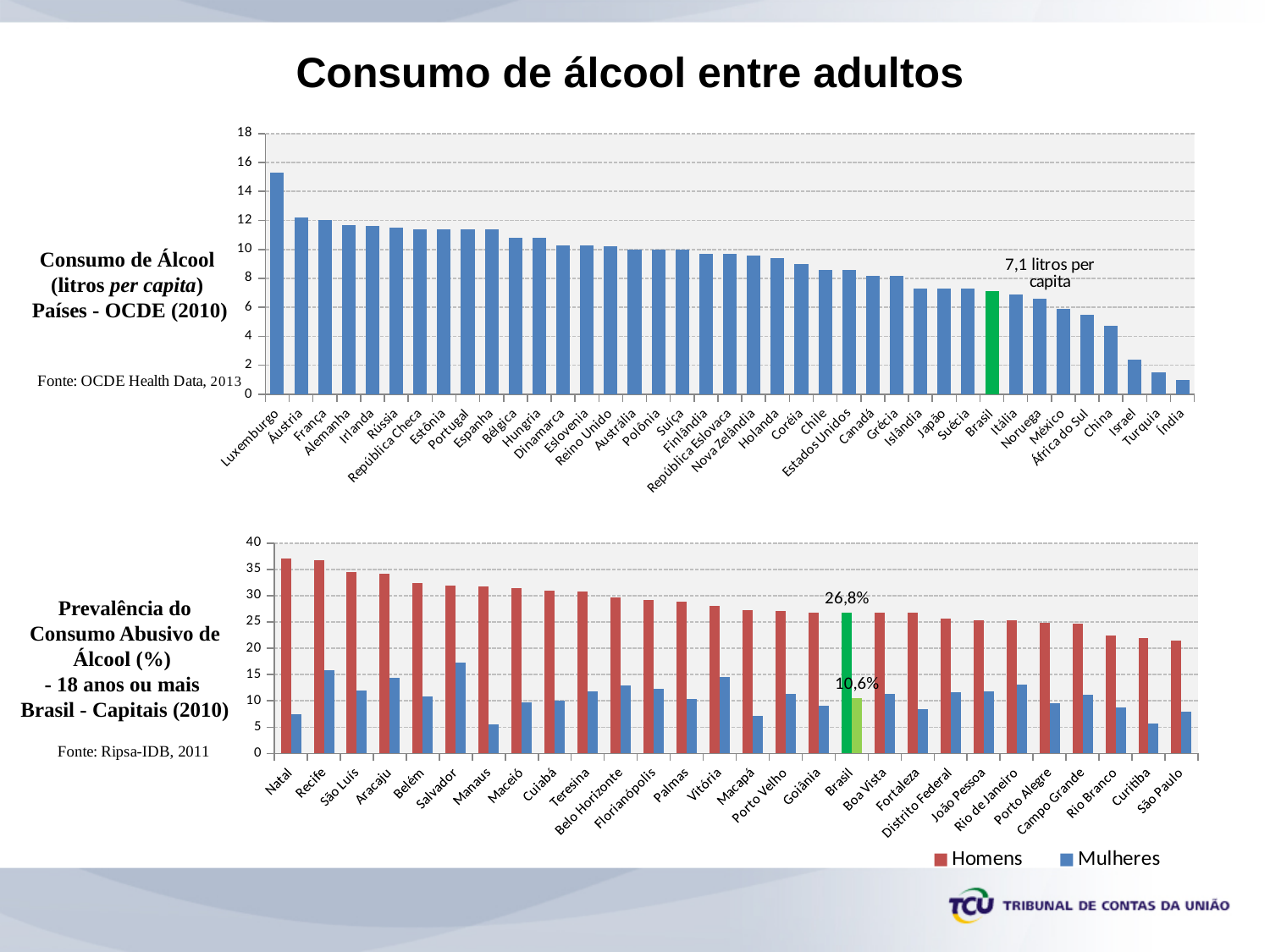
In the top chart (Consumo de Álcool, Países - OCDE 2010), do the values rise or fall from left to right along the x axis? fall In the top chart (Consumo de Álcool, Países - OCDE 2010), is the value for Luxemburgo greater or less than 14? greater In the bottom chart (Prevalência do Consumo Abusivo de Álcool, Brasil - Capitais 2010), is the Homens value for Natal greater or less than 35? greater How many series does the legend of the bottom chart (Prevalência do Consumo Abusivo de Álcool, Brasil - Capitais 2010) list? 2 What kind of chart is the top chart (Consumo de Álcool, Países - OCDE 2010)? bar chart In the bottom chart (Prevalência do Consumo Abusivo de Álcool, Brasil - Capitais 2010), what is the difference between the Homens and Mulheres values for Brasil? 16,2% In the bottom chart (Prevalência do Consumo Abusivo de Álcool, Brasil - Capitais 2010), what is the Homens value for Brasil? 26,8% In the bottom chart (Prevalência do Consumo Abusivo de Álcool, Brasil - Capitais 2010), what is the Mulheres value for Brasil? 10,6% In the top chart (Consumo de Álcool, Países - OCDE 2010), is the value for Turquia greater or less than 2? less In the top chart (Consumo de Álcool, Países - OCDE 2010), which country has the highest consumption? Luxemburgo In the top chart (Consumo de Álcool, Países - OCDE 2010), what is the value for Brasil? 7,1 litros per capita In the top chart (Consumo de Álcool, Países - OCDE 2010), which country has the lowest consumption? Índia